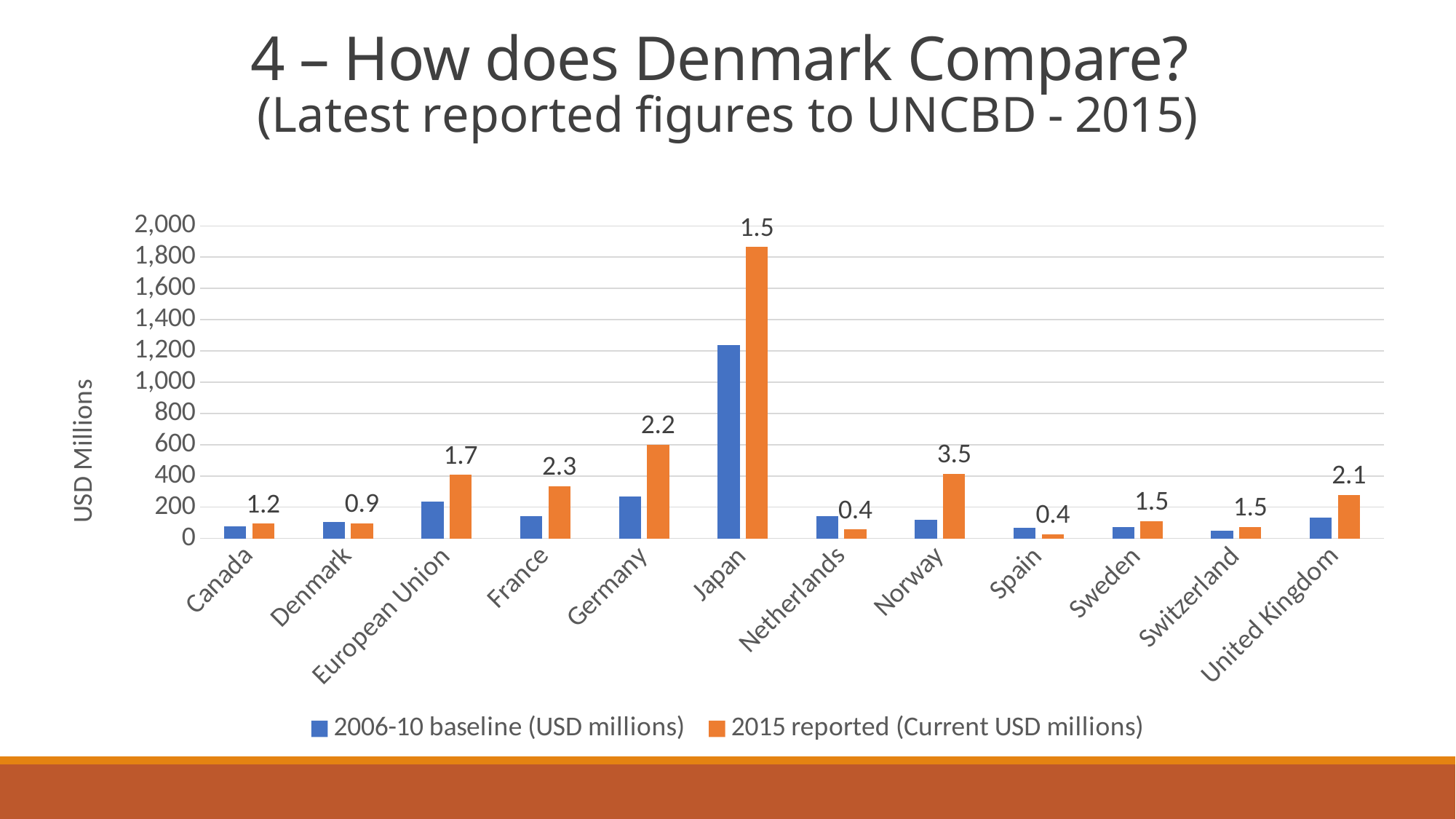
Which category has the highest 2015 reported (Current USD millions) bar? Japan Is the 2015 reported value for Norway greater or less than 200? greater Which is larger: the 2015 reported value for Germany or the 2015 reported value for Japan? Japan How many countries or regions are shown on the x axis of the chart? 12 Which category has the lowest 2015 reported (Current USD millions) bar? Spain What kind of chart is shown on the slide? bar chart How many series does the chart's legend list? 2 What is the label on the vertical axis of the chart? USD Millions Is the 2015 reported value for Netherlands greater or less than 200? less What number is printed above the 2015 reported bar for Norway? 3.5 Is the 2006-10 baseline value for Japan greater or less than 1,000? greater